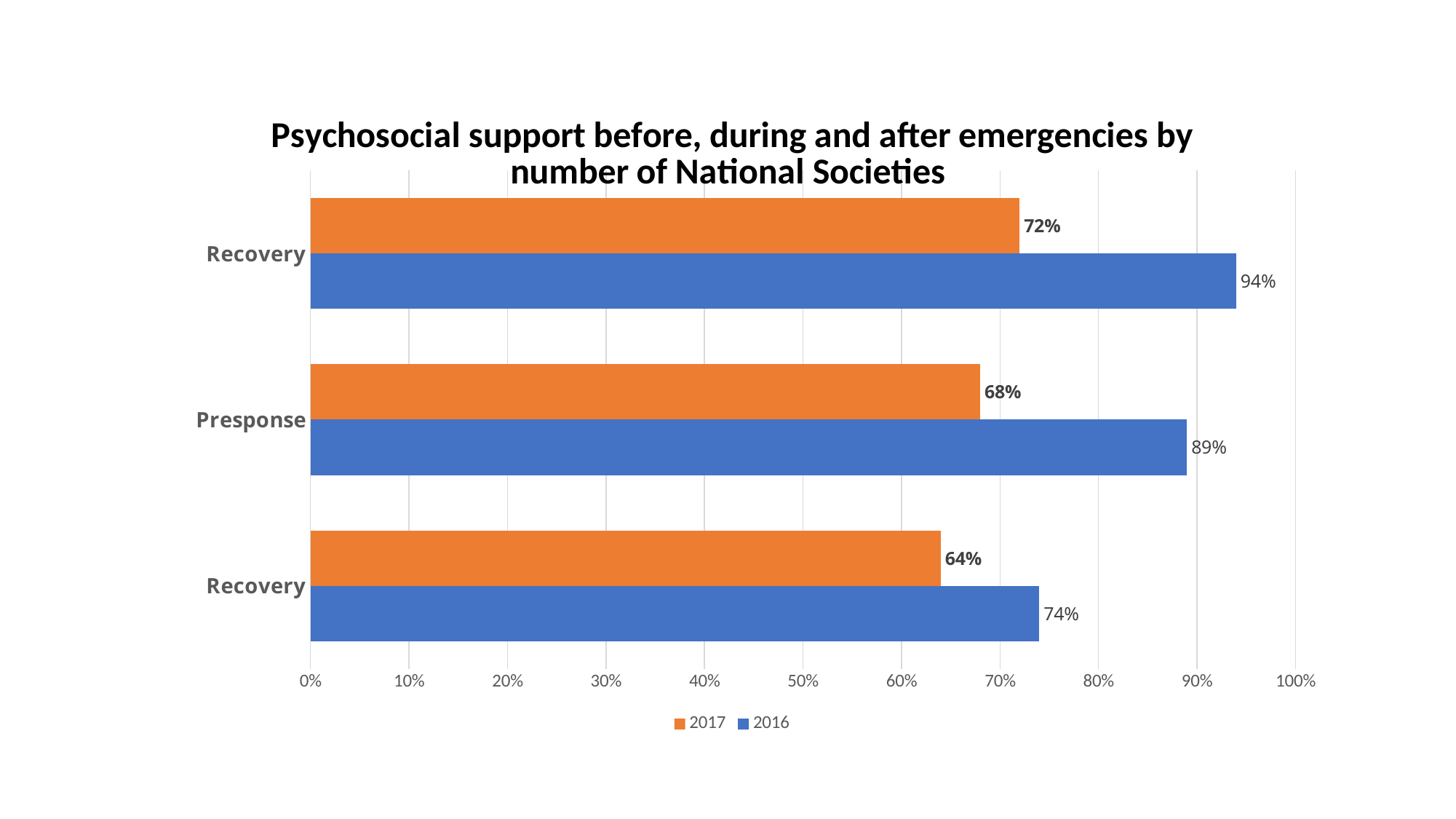
How many categories are shown on the chart? 3 What is the 2017 value for the bottom Recovery category? 64% What is the difference between the 2016 and 2017 values for the bottom Recovery category? 10% Which category has the highest 2016 value? Recovery (top) What is the 2016 value for the top Recovery category? 94% What is the 2016 value for Presponse? 89% How many series does the legend list? 2 What kind of chart is shown on the slide? Bar chart What is the difference between the 2016 and 2017 values for Presponse? 21% Which category has the lowest 2017 value? Recovery (bottom) For Presponse, which year has the larger value, 2016 or 2017? 2016 What is the 2017 value for Presponse? 68%